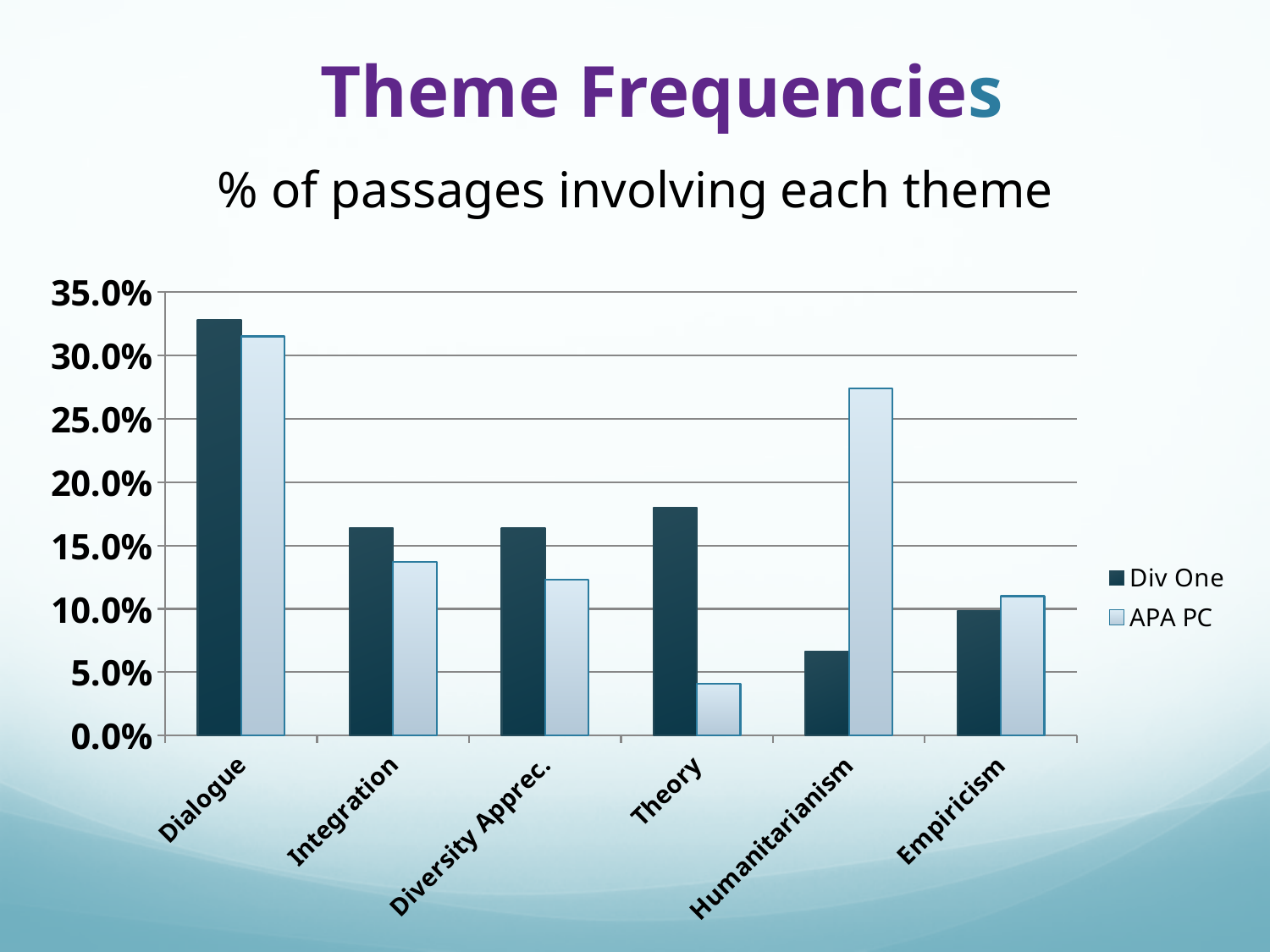
What kind of chart is shown on the slide? bar chart Which theme has the highest value for the Div One series? Dialogue For Humanitarianism, which series has the larger value, Div One or APA PC? APA PC Which theme has the lowest value for the Div One series? Humanitarianism How many series does the legend list? 2 For Theory, which series has the larger value, Div One or APA PC? Div One Which theme has the highest value for the APA PC series? Dialogue Which theme has the lowest value for the APA PC series? Theory How many themes (categories) are shown on the x axis? 6 What are the two series names listed in the legend? Div One and APA PC Is the Div One value for Dialogue greater or less than 30.0%? greater Is the APA PC value for Theory greater or less than 5.0%? less